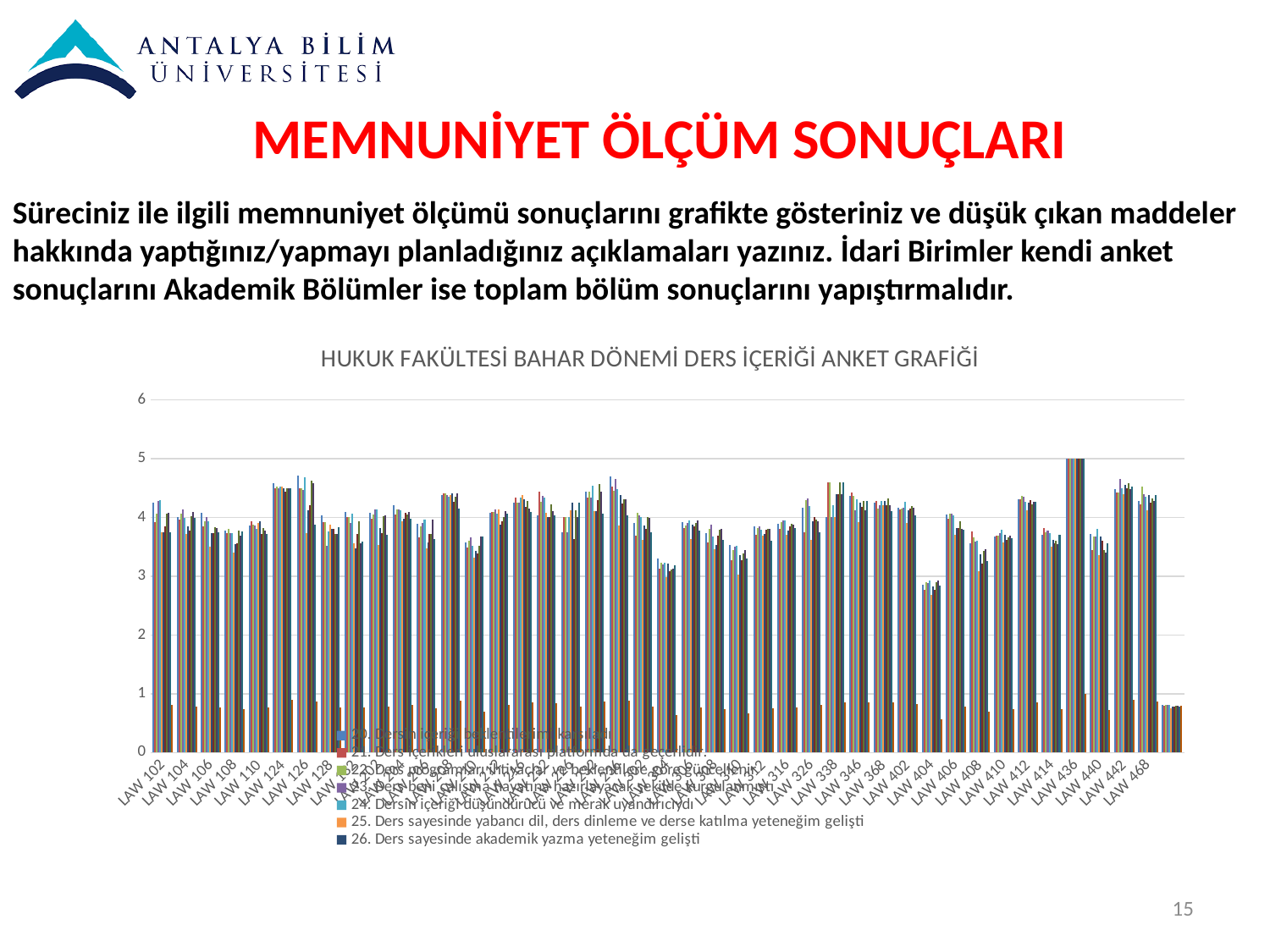
What kind of chart is shown on the slide? bar chart What is the highest value shown on the vertical axis of the chart? 6 Are the tallest bars for LAW 436 greater or less than 4? greater Which course category has the tallest bars in the chart? LAW 436 Are the tallest bars for LAW 436 higher or lower than the tallest bars for LAW 404? higher Are the tallest bars for LAW 404 greater or less than 3? less What is the title of the chart? HUKUK FAKÜLTESİ BAHAR DÖNEMİ DERS İÇERİĞİ ANKET GRAFİĞİ Are the tallest bars for LAW 102 greater or less than 3? greater How many series does the chart's legend list? 7 What is the last legend entry in the chart? 26. Ders sayesinde akademik yazma yeteneğim gelişti